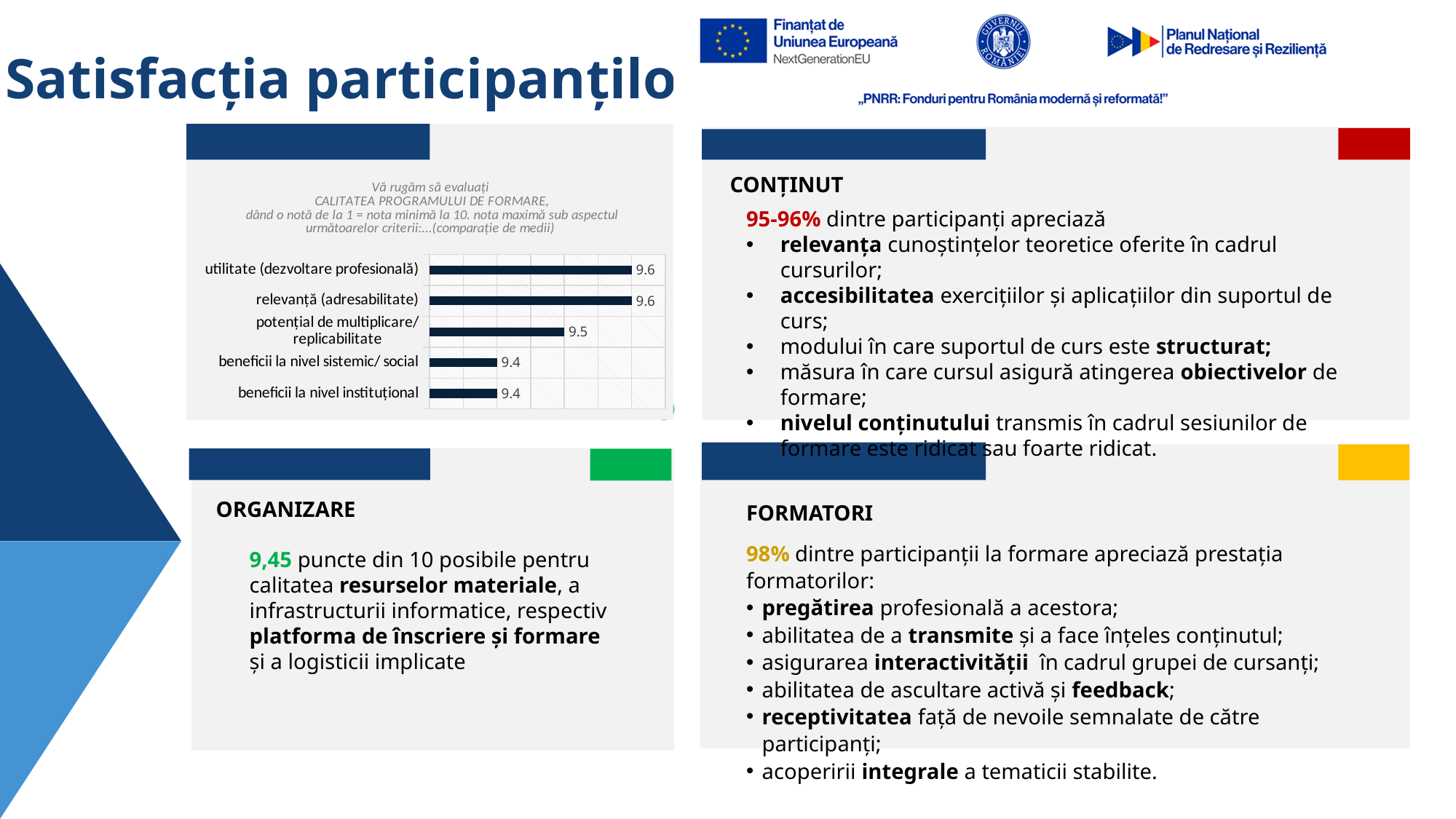
What value is shown for 'beneficii la nivel instituțional'? 9.4 How many categories are shown in the chart? 5 Do the values increase or decrease going from the top category to the bottom category of the chart? decrease What is the lowest value shown in the chart? 9.4 Which has a larger value: 'potențial de multiplicare/ replicabilitate' or 'beneficii la nivel sistemic/ social'? potențial de multiplicare/ replicabilitate What value is shown for 'potențial de multiplicare/ replicabilitate'? 9.5 What value is shown for 'utilitate (dezvoltare profesională)'? 9.6 What kind of chart is shown on the slide? bar chart What is the highest value shown in the chart? 9.6 What value is shown for 'beneficii la nivel sistemic/ social'? 9.4 What value is shown for 'relevanță (adresabilitate)'? 9.6 What is the difference between the value for 'utilitate (dezvoltare profesională)' and the value for 'beneficii la nivel instituțional'? 0.2